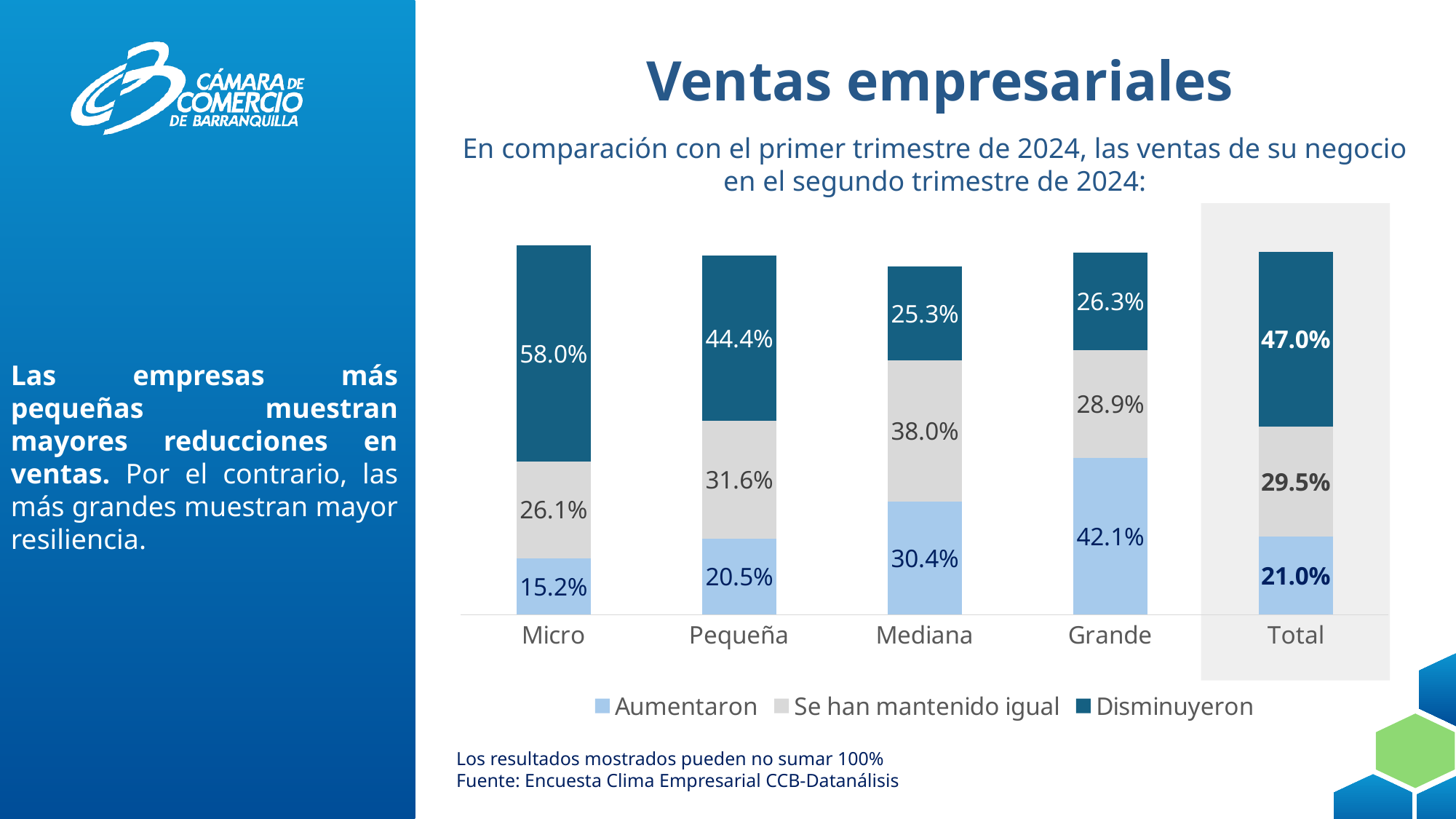
What percentage of Micro businesses reported that sales decreased (Disminuyeron)? 58.0% What is the Disminuyeron value for the Total category? 47.0% Which series is shown in the darkest blue colour? Disminuyeron Which is larger: the Aumentaron value for Mediana or for Pequeña? Mediana Which category has the highest Aumentaron value? Grande How many categories are shown on the x axis? 5 What is the value for Aumentaron in the Grande category? 42.1% What is the value for Se han mantenido igual in the Mediana category? 38.0% What is the difference between the Disminuyeron values for Micro and Pequeña? 13.6% How many series does the legend list? 3 Which category has the lowest Disminuyeron value? Mediana What type of chart is shown on the slide? Stacked bar chart